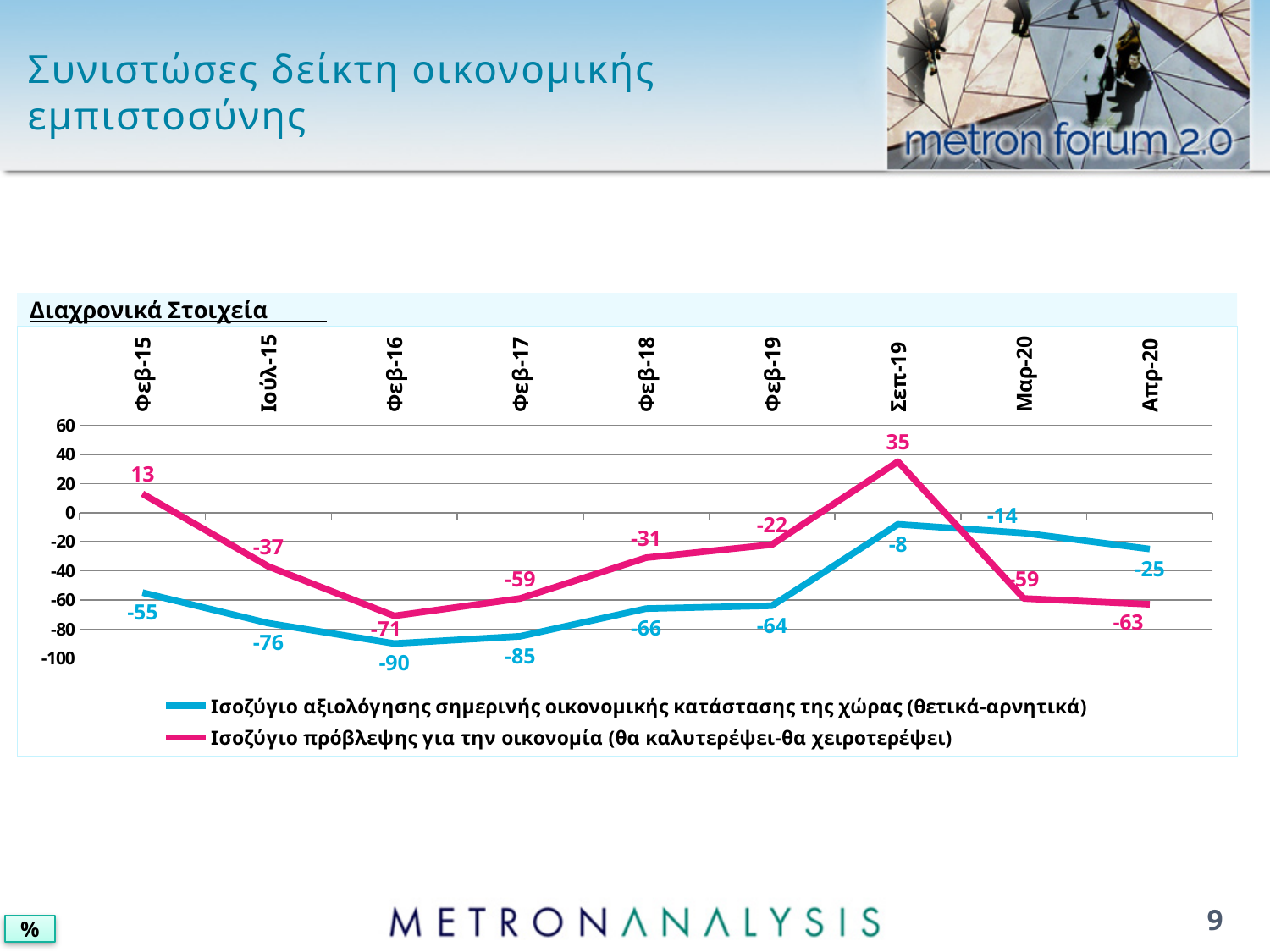
How many time points are shown on the x axis of the chart? 9 What is the value of the blue series (Ισοζύγιο αξιολόγησης σημερινής οικονομικής κατάστασης της χώρας) for Φεβ-16? -90 At which time point does the blue series (Ισοζύγιο αξιολόγησης σημερινής οικονομικής κατάστασης) reach its highest value? Σεπ-19 What is the heading shown above the chart? Διαχρονικά Στοιχεία At which time point does the pink series (Ισοζύγιο πρόβλεψης για την οικονομία) reach its lowest value? Φεβ-16 What is the difference between the pink series value for Σεπ-19 (35) and its value for Μαρ-20 (-59)? 94 Does the blue series rise or fall between Φεβ-19 and Σεπ-19? Rise How many series does the chart legend list? 2 For Φεβ-15, which series has the higher value: the blue series or the pink series? The pink series (Ισοζύγιο πρόβλεψης για την οικονομία) What is the value of the pink series (Ισοζύγιο πρόβλεψης για την οικονομία) for Απρ-20? -63 What type of chart is shown on the slide? Line chart What is the value of the pink series (Ισοζύγιο πρόβλεψης για την οικονομία) for Σεπ-19? 35